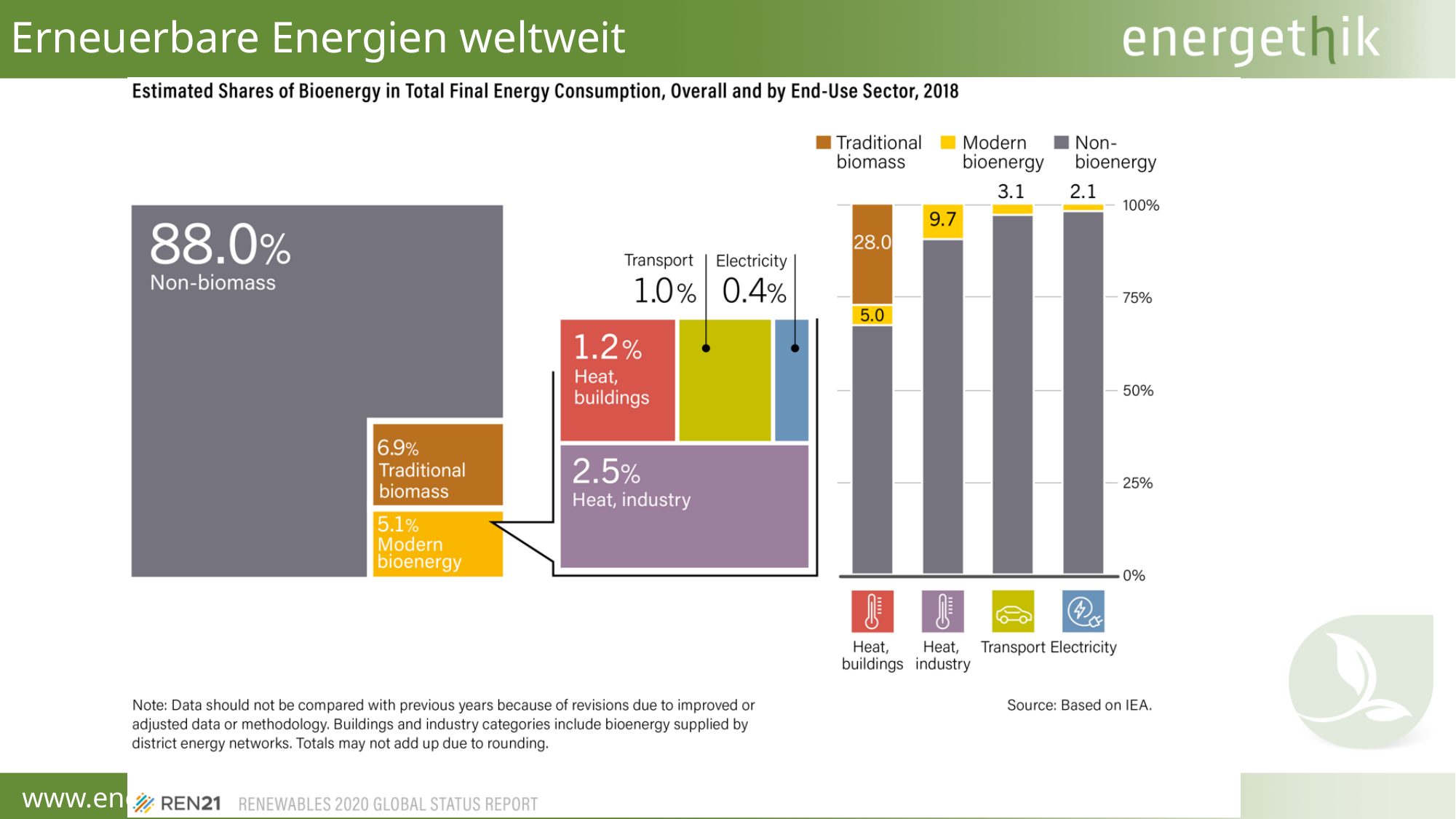
In the left treemap chart, what share is shown for Non-biomass? 88.0% In the stacked bar chart on the right, what is the Modern bioenergy value for Heat, industry? 9.7 What kind of chart is the chart on the right of the slide? Stacked bar chart In the stacked bar chart on the right, what is the difference between the Modern bioenergy values for Heat, industry and Transport? 6.6 In the stacked bar chart on the right, what is the Traditional biomass value for Heat, buildings? 28.0 In the left treemap chart, what share is shown for Electricity? 0.4% How many series does the legend of the stacked bar chart on the right list? 3 In the left treemap chart, what share is shown for Heat, industry? 2.5% How many end-use sector categories are shown on the x axis of the stacked bar chart on the right? 4 In the stacked bar chart on the right, which sector has the highest Modern bioenergy value? Heat, industry In the left treemap chart, what share is shown for Modern bioenergy? 5.1% In the left treemap chart, what share is shown for Traditional biomass? 6.9%